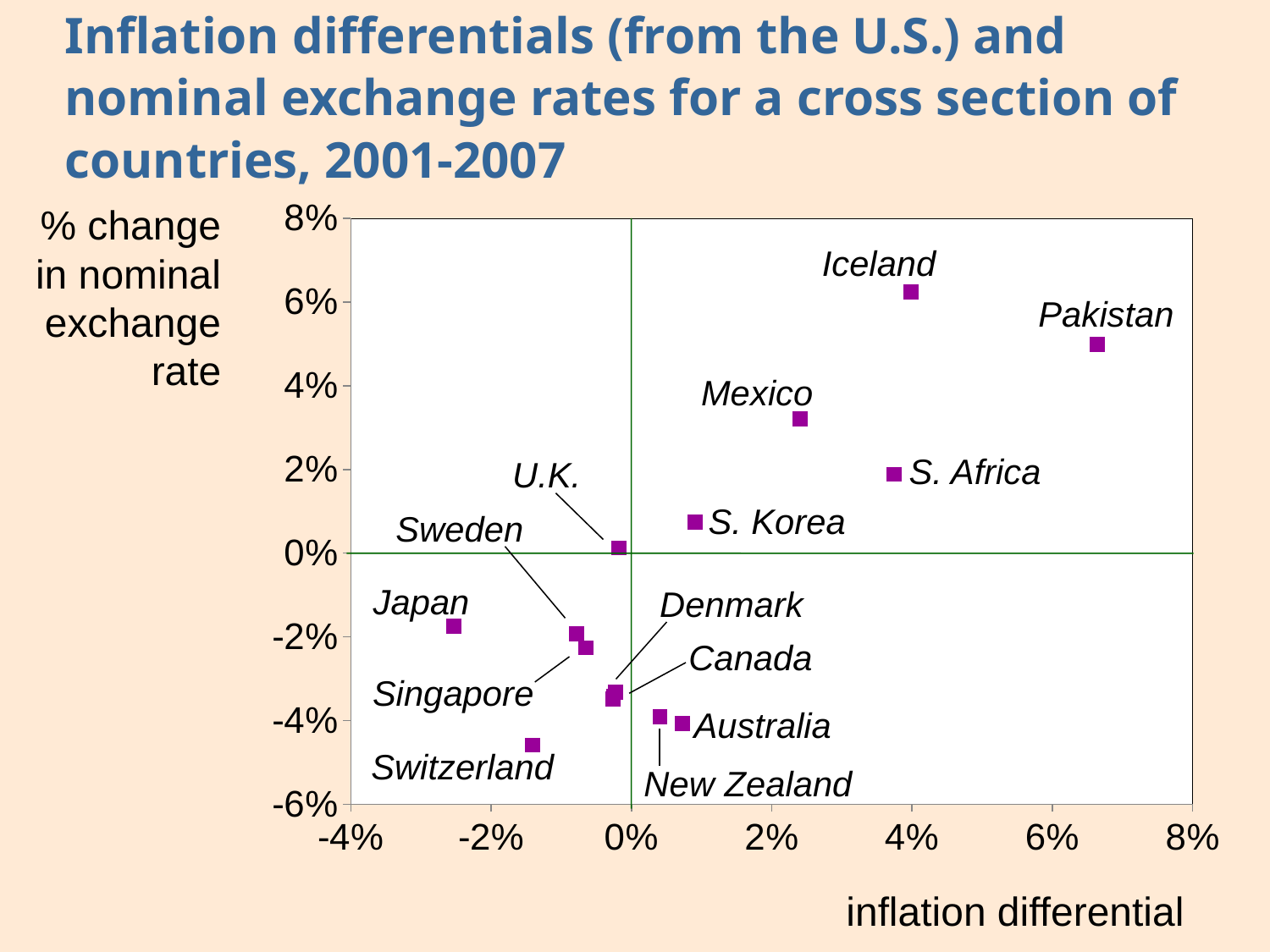
Which country has the highest % change in nominal exchange rate? Iceland Which country has the lowest % change in nominal exchange rate? Switzerland What kind of chart is shown on the slide? scatter chart Is the % change in nominal exchange rate for Iceland greater or less than 6%? greater Which country has the lowest inflation differential? Japan Is the % change in nominal exchange rate for Switzerland greater or less than -4%? less Is the inflation differential for Pakistan greater or less than 6%? greater Which country has the highest inflation differential? Pakistan Which has a higher inflation differential, S. Africa or S. Korea? S. Africa Which has a higher % change in nominal exchange rate, Iceland or Mexico? Iceland What is the label of the horizontal axis? inflation differential